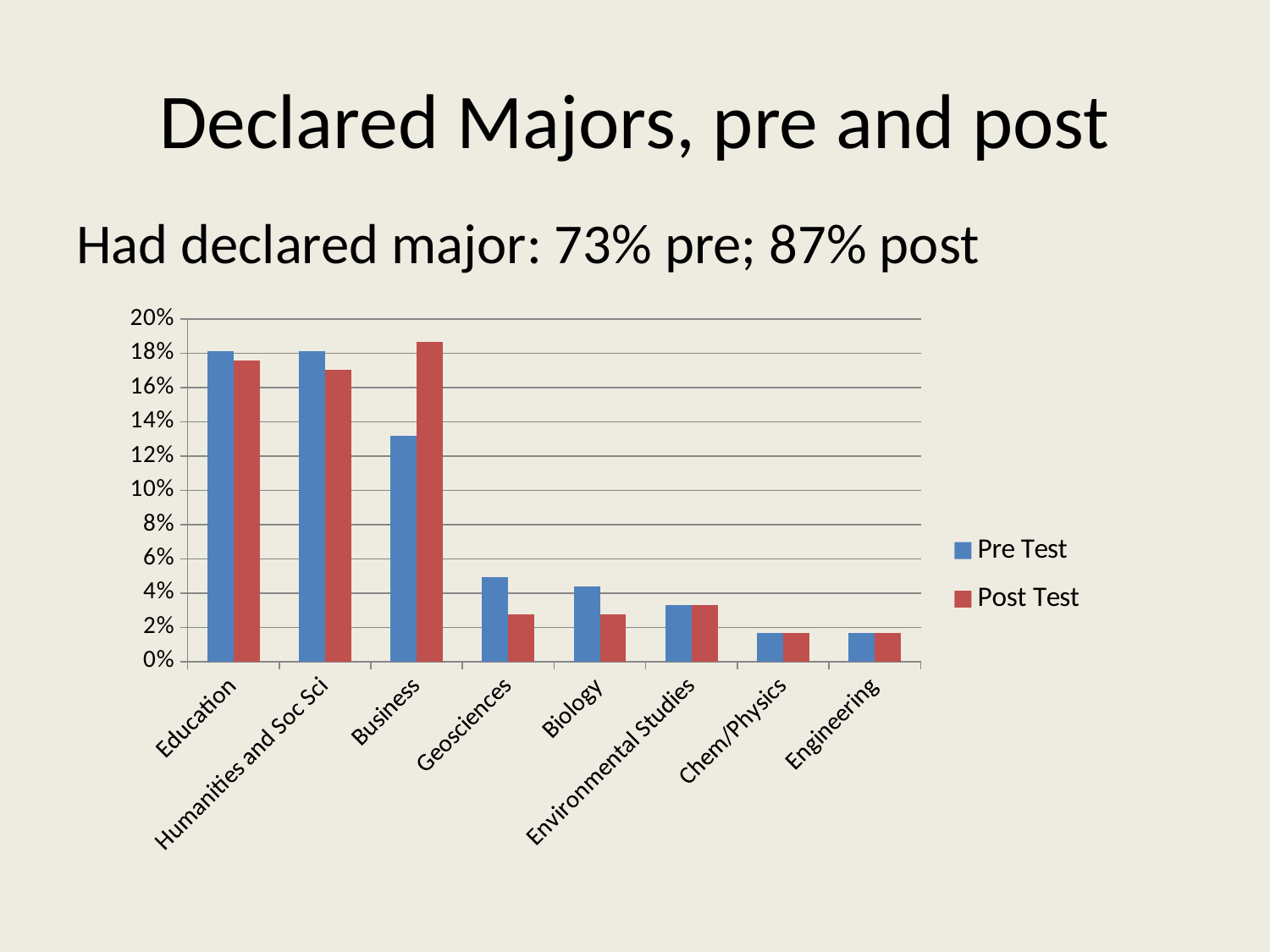
For Geosciences, which is larger: the Pre Test or the Post Test value? Pre Test How many major categories are shown on the x axis? 8 Is the Pre Test value for Geosciences greater or less than 4%? greater What is the title of the slide containing the chart? Declared Majors, pre and post Is the Post Test value for Business greater or less than 18%? greater Which series is shown in red? Post Test How many series does the legend list? 2 For Business, which is larger: the Pre Test or the Post Test value? Post Test What kind of chart is shown on the slide? bar chart Which category has the highest Post Test value? Business Is the Pre Test value for Business greater or less than 14%? less